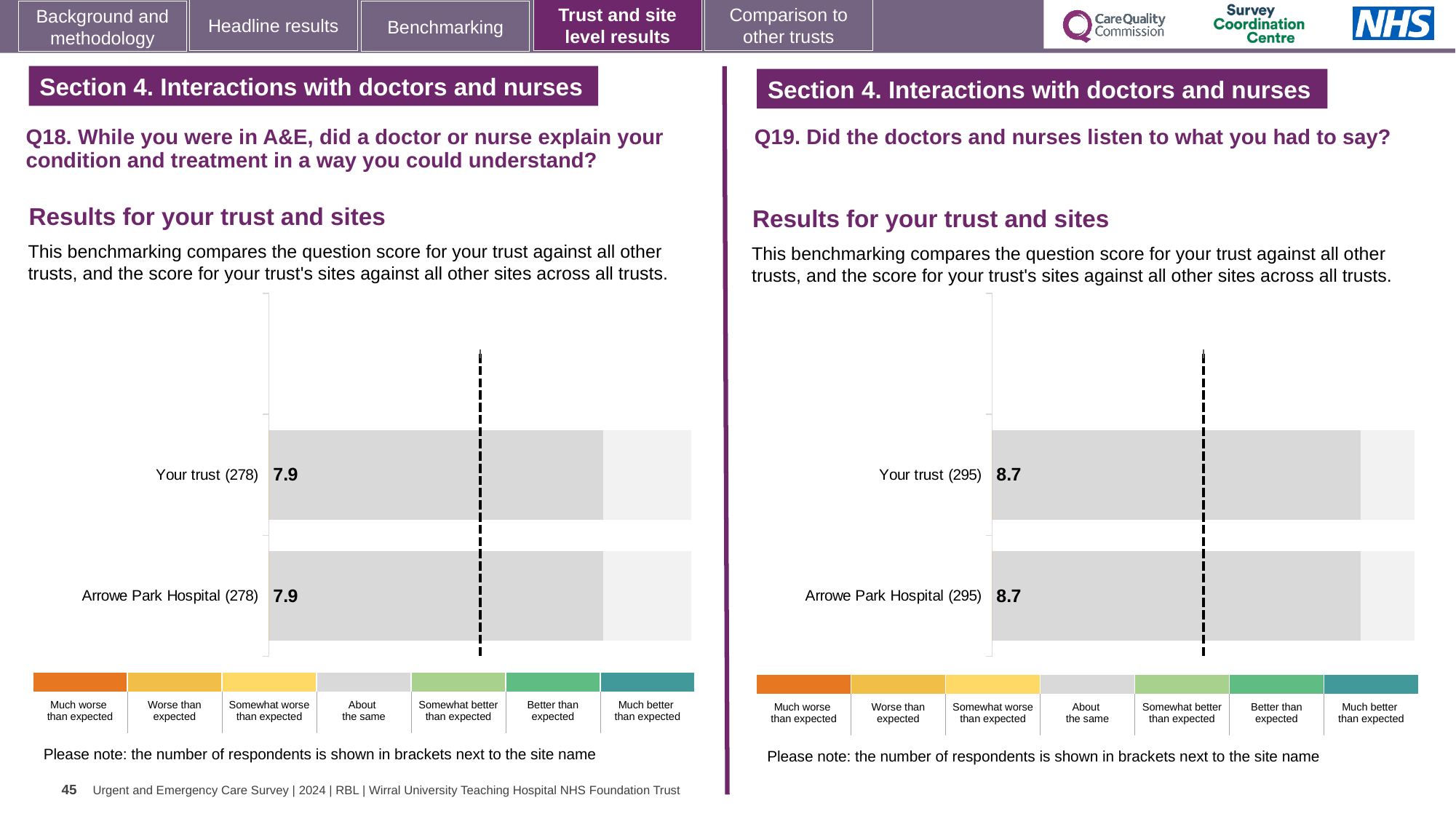
Which is larger: the Your trust score in the Q18 chart on the left or the Your trust score in the Q19 chart on the right? Q19 (8.7) In the Q19 chart on the right, which benchmark category does the grey colour of the bars correspond to in the legend? About the same In the Q18 chart on the left, how many respondents are shown in brackets for Your trust? 278 How many bars are plotted in the Q18 chart on the left? 2 What is the difference between the Your trust score in the Q19 chart on the right and the Your trust score in the Q18 chart on the left? 0.8 What kind of chart is used in the Q19 chart on the right? Bar chart In the Q19 chart on the right, how many respondents are shown in brackets for Arrowe Park Hospital? 295 In the Q18 chart on the left, what is the score for Your trust? 7.9 In the Q19 chart on the right, what is the score for Arrowe Park Hospital? 8.7 In the Q19 chart on the right, what is the score for Your trust? 8.7 In the Q18 chart on the left, what is the difference between the score for Your trust and the score for Arrowe Park Hospital? 0 In the Q18 chart on the left, what is the score for Arrowe Park Hospital? 7.9